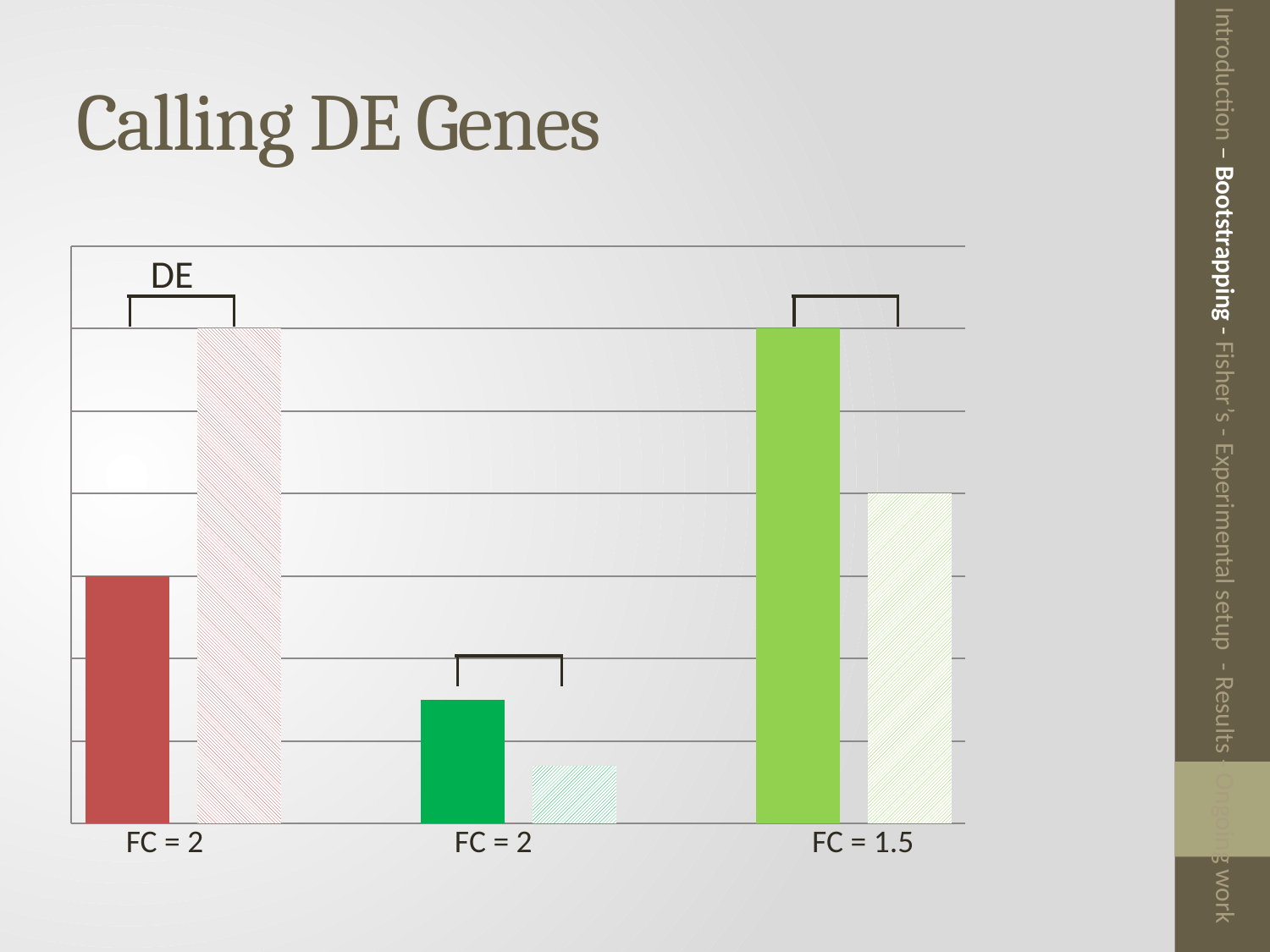
In the FC = 1.5 group, is the solid bar or the hatched bar taller? the solid bar Which group of bars has the shortest bars on the chart? the middle FC = 2 group Is the tallest bar in the leftmost FC = 2 group taller or shorter than the tallest bar in the middle FC = 2 group? taller Which group of bars is annotated with the text "DE" above it? the leftmost FC = 2 group What kind of chart is shown on the slide? bar chart How many bars are plotted in total on the chart? 6 In the middle FC = 2 group, is the solid bar or the hatched bar taller? the solid bar How many category groups are labelled along the x axis of the chart? 3 What is the x-axis label of the rightmost group of bars? FC = 1.5 Which x-axis label appears on two different groups of bars? FC = 2